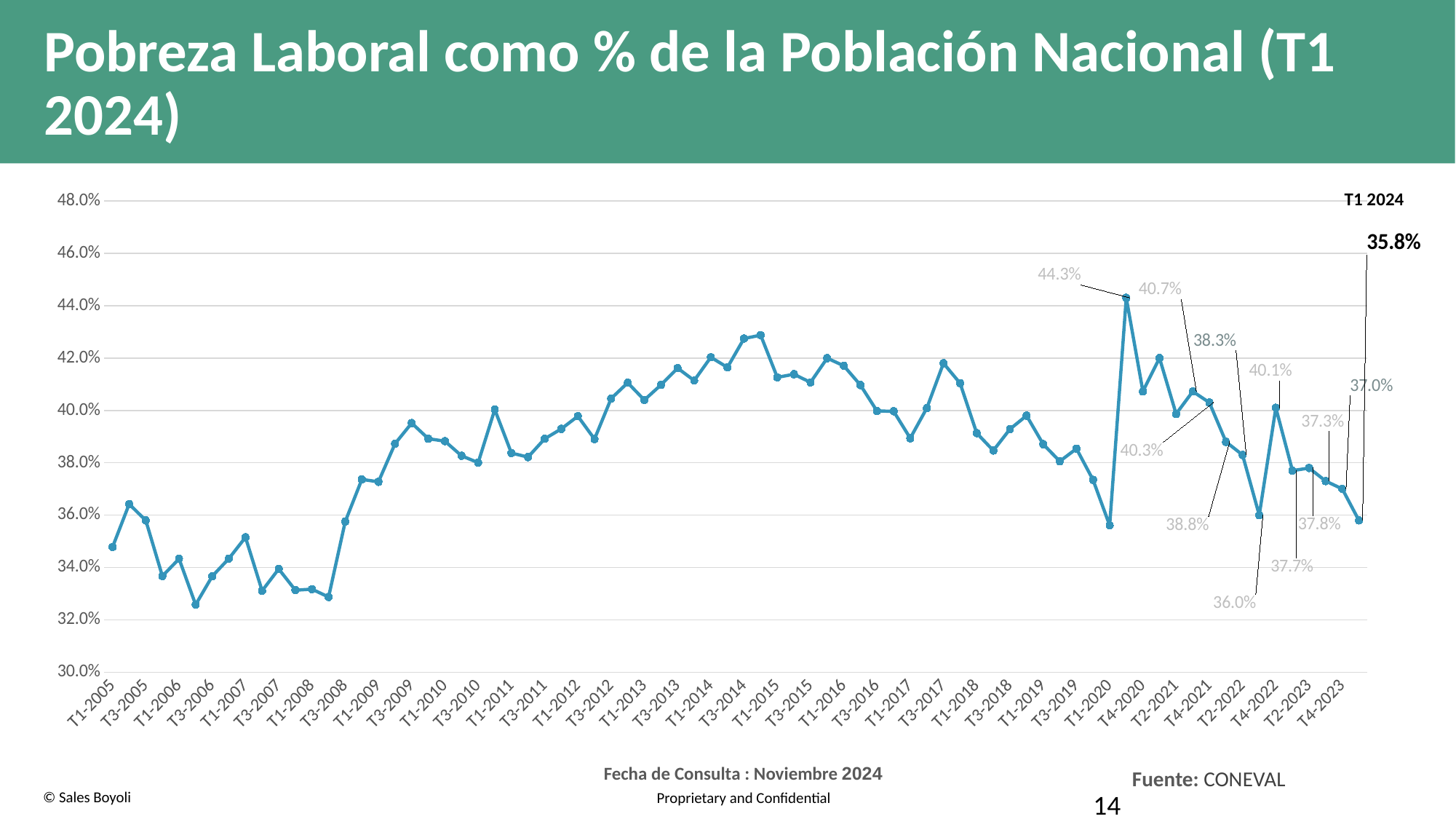
What source is cited for the chart data? CONEVAL Is the value for T3-2014 greater or less than 42.0%? greater What is the difference between the peak labeled value of 44.3% and the T1 2024 value of 35.8%? 8.5 percentage points Is the value for T1-2005 greater or less than 36.0%? less Between T3-2008 and T3-2009, do the values rise or fall? rise What is the highest value reached on the line, as printed on its data label? 44.3% Among the data labels printed on the chart, which is the lowest value? 35.8% What is the labor poverty value shown for T1 2024? 35.8% Is the value for T3-2006 greater or less than 34.0%? less Which is larger, the value for T1-2009 or the value for T1-2005? T1-2009 How many data labels with values are printed on the chart? 12 What kind of chart is shown on the slide? line chart